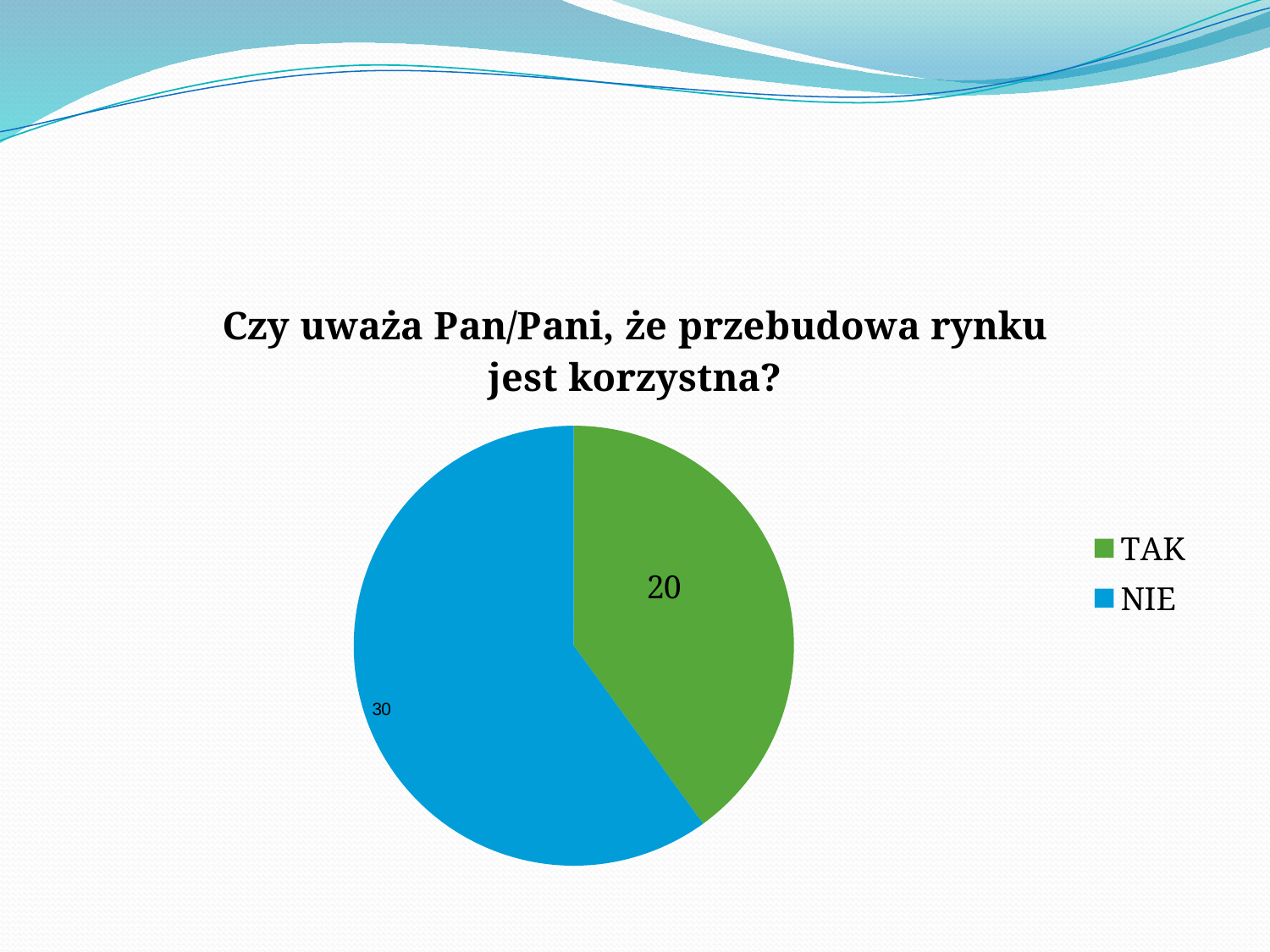
What type of chart is shown on the slide? pie chart What is the total of all slices in the pie chart? 50 What is the difference between the values for NIE and TAK? 10 How many entries does the legend list? 2 What is the value for NIE? 30 What is the value for TAK? 20 How many categories does the pie chart have? 2 What colour is the NIE slice? blue Which is larger, the value for TAK or the value for NIE? NIE Which category has the largest slice? NIE Which category has the smallest slice? TAK What share of the pie does the TAK slice represent? 40%